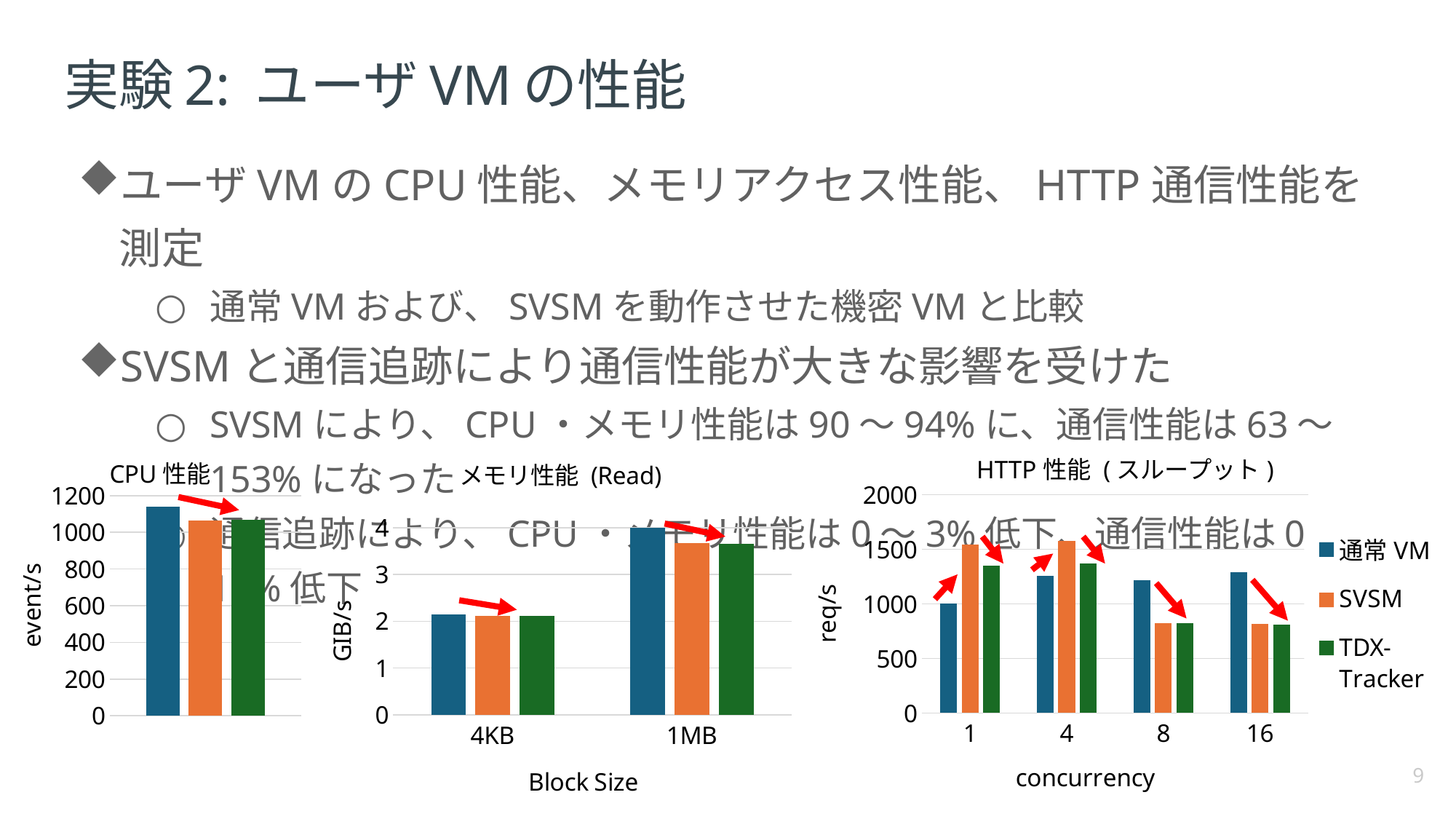
In the メモリ性能 (Read) chart, is the value for 通常 VM at 4KB greater or less than 3? less What type of chart is the HTTP 性能（スループット） chart? bar chart In the CPU 性能 chart, which is larger, the value for 通常 VM or the value for SVSM? 通常 VM In the メモリ性能 (Read) chart, is the value for SVSM at 1MB greater or less than 4? less In the メモリ性能 (Read) chart, do the values for 通常 VM rise or fall from 4KB to 1MB? rise In the HTTP 性能（スループット） chart, how many concurrency categories are shown on the x axis? 4 What is the y-axis label of the CPU 性能 chart? event/s How many series does the legend list for the charts on the slide? 3 In the CPU 性能 chart, is the value for 通常 VM greater or less than 1000? greater In the HTTP 性能（スループット） chart, which is larger at concurrency 1, the value for 通常 VM or the value for SVSM? SVSM In the HTTP 性能（スループット） chart, which series has the highest value at concurrency 16? 通常 VM